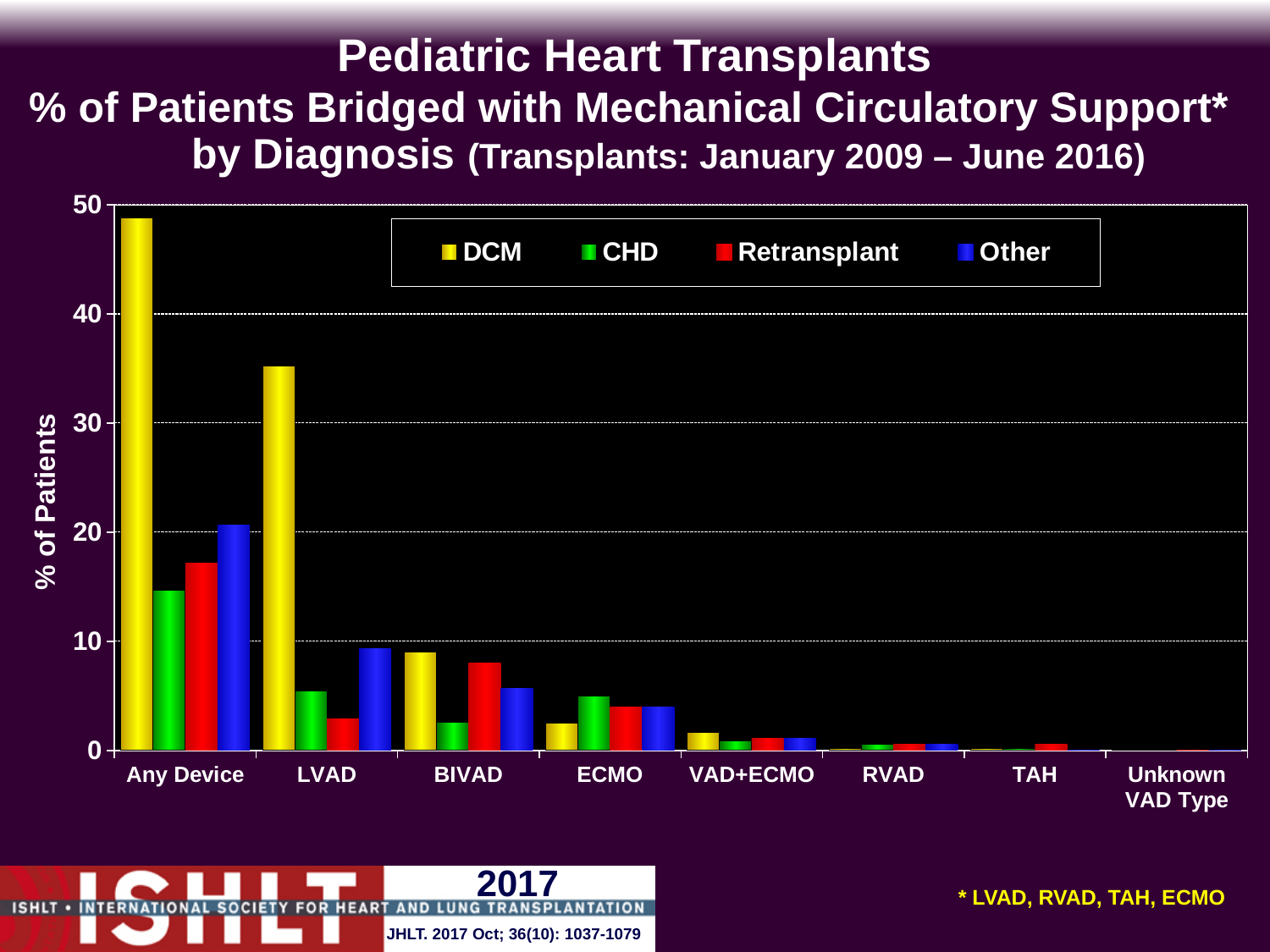
Is the DCM value for LVAD greater or less than 30? greater How many device categories are shown along the x axis? 8 How many series does the legend list? 4 Is the CHD value for Any Device greater or less than 20? less For the Any Device category, which is larger: the Other bar or the CHD bar? Other What kind of chart is shown on the slide? bar chart Is the Retransplant value for BIVAD greater or less than 10? less For the LVAD category, which diagnosis has the lowest percentage of patients? Retransplant For the Any Device category, which diagnosis has the highest percentage of patients? DCM For the LVAD category, which is larger: the Other bar or the Retransplant bar? Other What is the title of the y axis? % of Patients